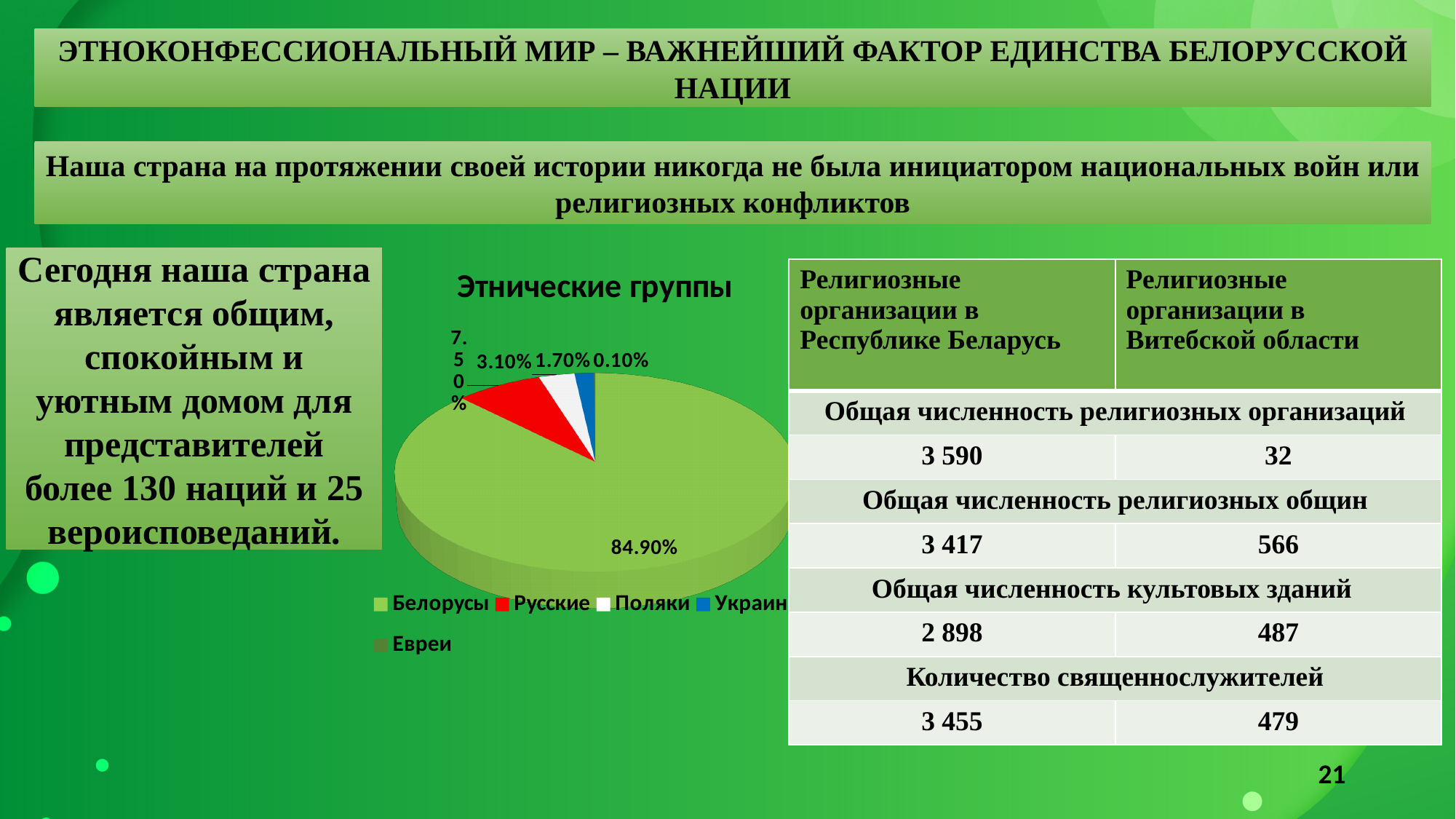
What colour is the Русские slice in the "Этнические группы" pie chart? red In the "Этнические группы" pie chart, what is the difference between the shares of Поляки and Евреи? 3.00% Which ethnic group has the largest slice in the "Этнические группы" pie chart? Белорусы In the "Этнические группы" pie chart, what share is shown for Белорусы? 84.90% In the "Этнические группы" pie chart, which slice is larger: Русские or Поляки? Русские In the "Этнические группы" pie chart, what share is shown for Русские? 7.50% What is the title of the pie chart on the slide? Этнические группы In the "Этнические группы" pie chart, what share is shown for Поляки? 3.10% How many ethnic groups are listed in the legend of the "Этнические группы" pie chart? 5 Which ethnic group has the smallest slice in the "Этнические группы" pie chart? Евреи What kind of chart is the "Этнические группы" chart? pie chart In the "Этнические группы" pie chart, what share is shown for Евреи? 0.10%